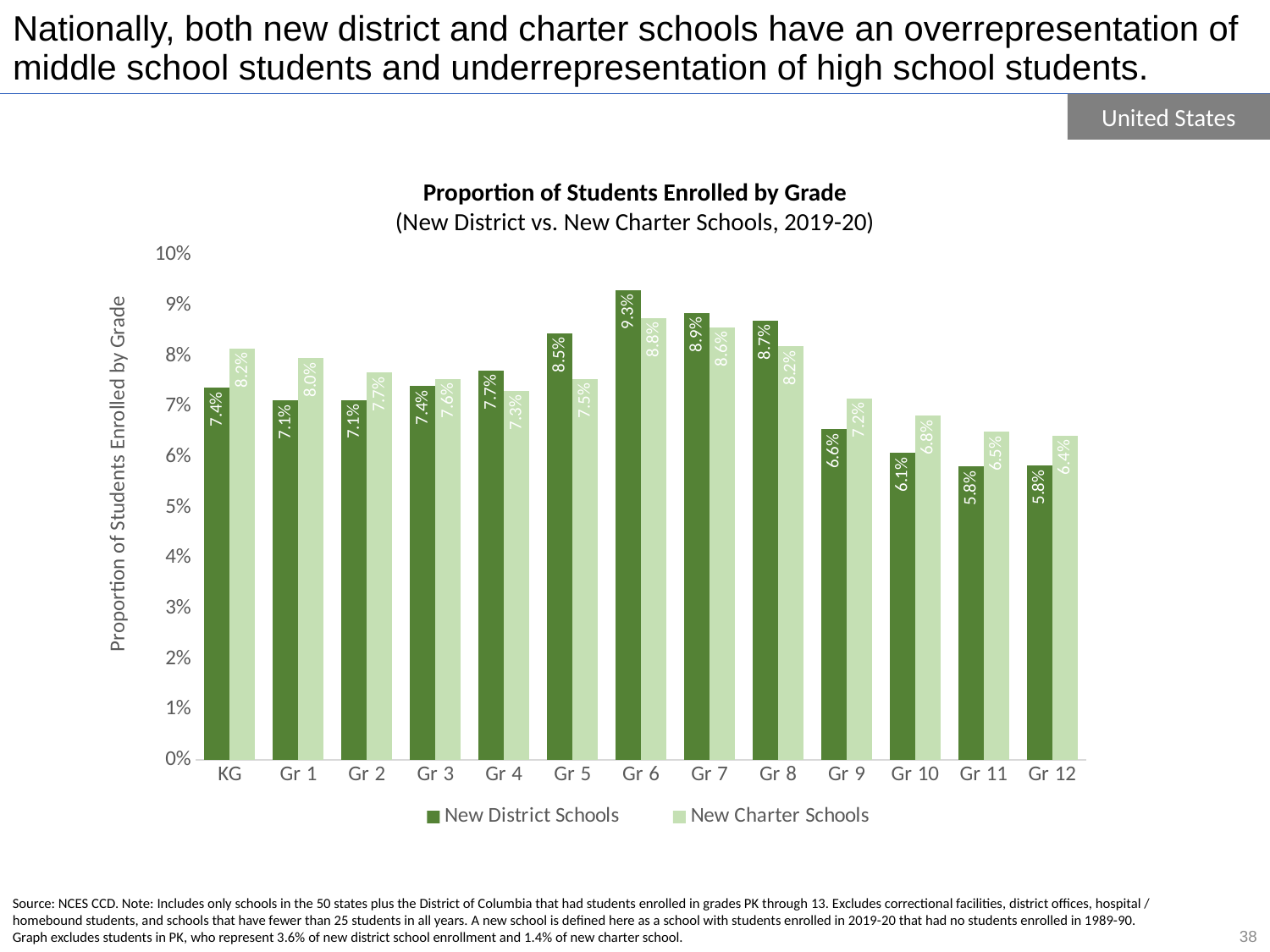
What is the proportion of students enrolled in KG for New Charter Schools? 8.2% In Gr 5, which series has the larger value, New District Schools or New Charter Schools? New District Schools Which grade has the highest proportion for New District Schools? Gr 6 What is the value for New Charter Schools in Gr 10? 6.8% What type of chart is shown on the slide? bar chart Do the New District Schools values rise or fall from Gr 8 to Gr 12? fall What is the difference between New District Schools and New Charter Schools in Gr 9? 0.6% Is the value for New District Schools in Gr 11 greater or less than 6%? less Which grade has the lowest proportion for New Charter Schools? Gr 12 How many grade categories are shown on the x axis? 13 What is the proportion of students enrolled in Gr 6 for New District Schools? 9.3% How many series does the legend list? 2